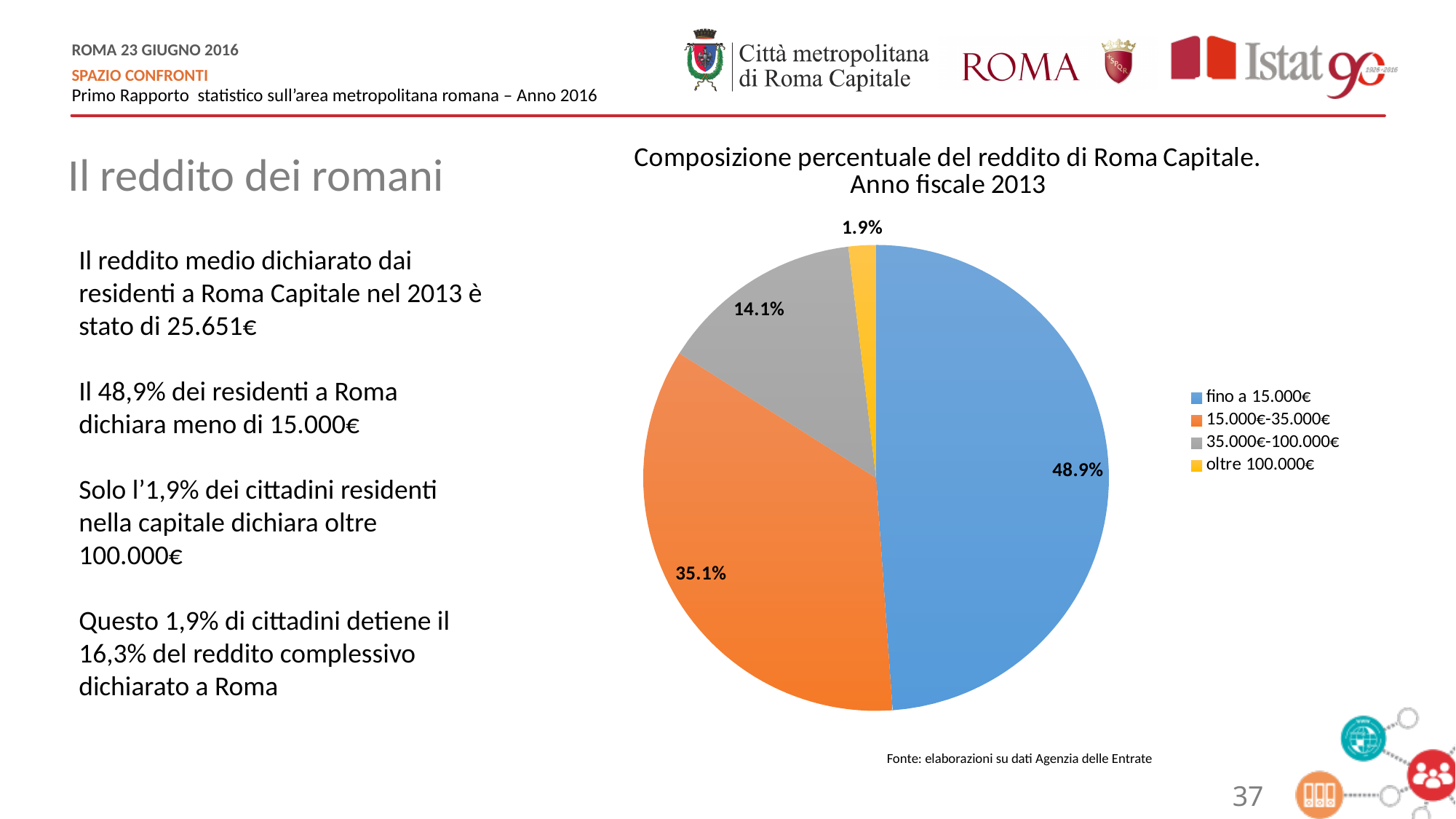
How many categories does the pie chart show? 4 What is the value shown for the 'oltre 100.000€' category? 1.9% What colour is the 'oltre 100.000€' slice? yellow Which category has the smallest slice of the pie? oltre 100.000€ What kind of chart is shown on the slide? pie chart Which is larger: the '35.000€-100.000€' slice or the 'oltre 100.000€' slice? 35.000€-100.000€ Which category has the largest slice of the pie? fino a 15.000€ What is the difference between the 'fino a 15.000€' and '15.000€-35.000€' shares? 13.8% What share of the pie does the 'fino a 15.000€' slice represent? 48.9% What is the value shown for the '35.000€-100.000€' category? 14.1% What is the value shown for the '15.000€-35.000€' category? 35.1% What is the title of the chart? Composizione percentuale del reddito di Roma Capitale. Anno fiscale 2013